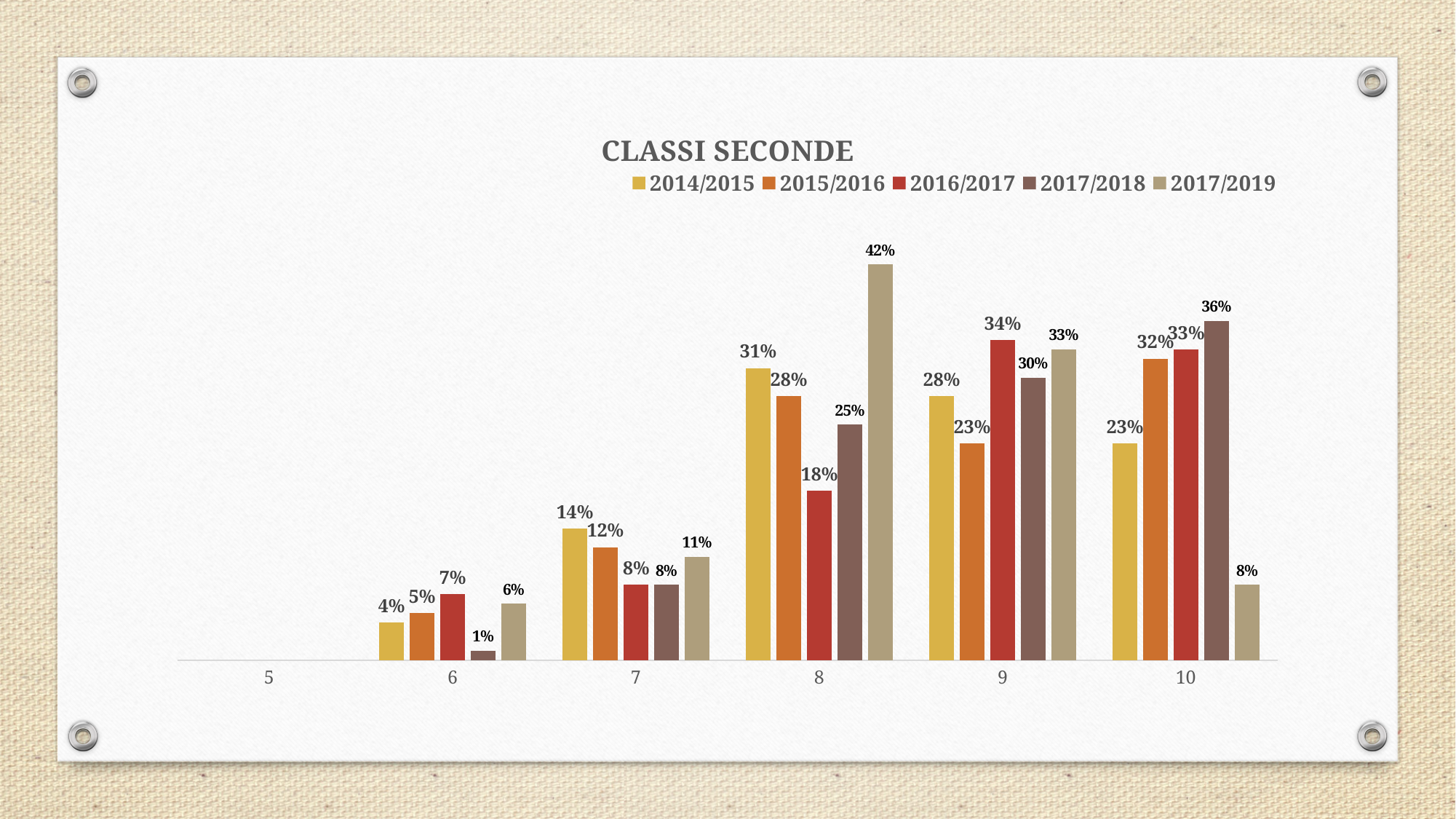
What is the difference between the 2017/2018 and 2017/2019 values for category 10? 28% How many series does the legend list? 5 Which category has the highest value in the 2016/2017 series? 9 What is the value for category 8 in the 2017/2019 series? 42% What is the title of the chart? CLASSI SECONDE What kind of chart is shown on the slide? Bar chart Which category has the lowest value in the 2014/2015 series? 6 How many categories are shown on the x axis? 6 Which is larger for category 8: the 2014/2015 value or the 2016/2017 value? 2014/2015 What is the value for category 6 in the 2017/2018 series? 1% Does the 2017/2019 series rise or fall from category 9 to category 10? Fall What is the value for category 10 in the 2014/2015 series? 23%